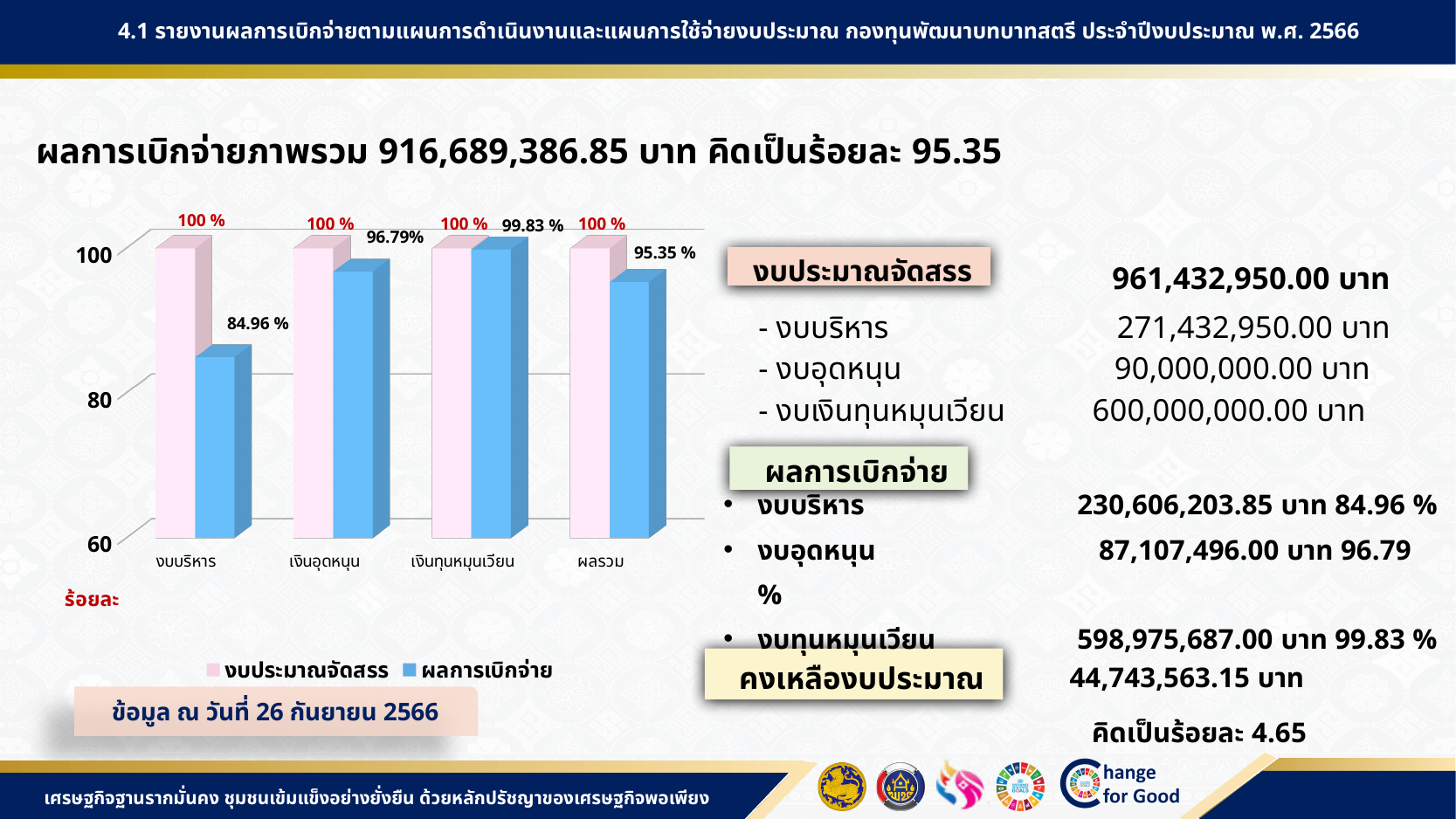
Which category has the highest ผลการเบิกจ่าย value? เงินทุนหมุนเวียน What is the งบประมาณจัดสรร value for เงินอุดหนุน? 100 % What is the ผลการเบิกจ่าย value for ผลรวม? 95.35 % Which is larger, the ผลการเบิกจ่าย value for เงินอุดหนุน or for ผลรวม? เงินอุดหนุน What kind of chart is shown on the slide? bar chart What is the ผลการเบิกจ่าย value for เงินอุดหนุน? 96.79% How many categories are shown on the x axis of the chart? 4 How many series does the chart legend list? 2 What is the ผลการเบิกจ่าย value for งบบริหาร? 84.96 % What is the difference between the ผลการเบิกจ่าย values for เงินทุนหมุนเวียน and งบบริหาร? 14.87 Which category has the lowest ผลการเบิกจ่าย value? งบบริหาร What is the ผลการเบิกจ่าย value for เงินทุนหมุนเวียน? 99.83 %